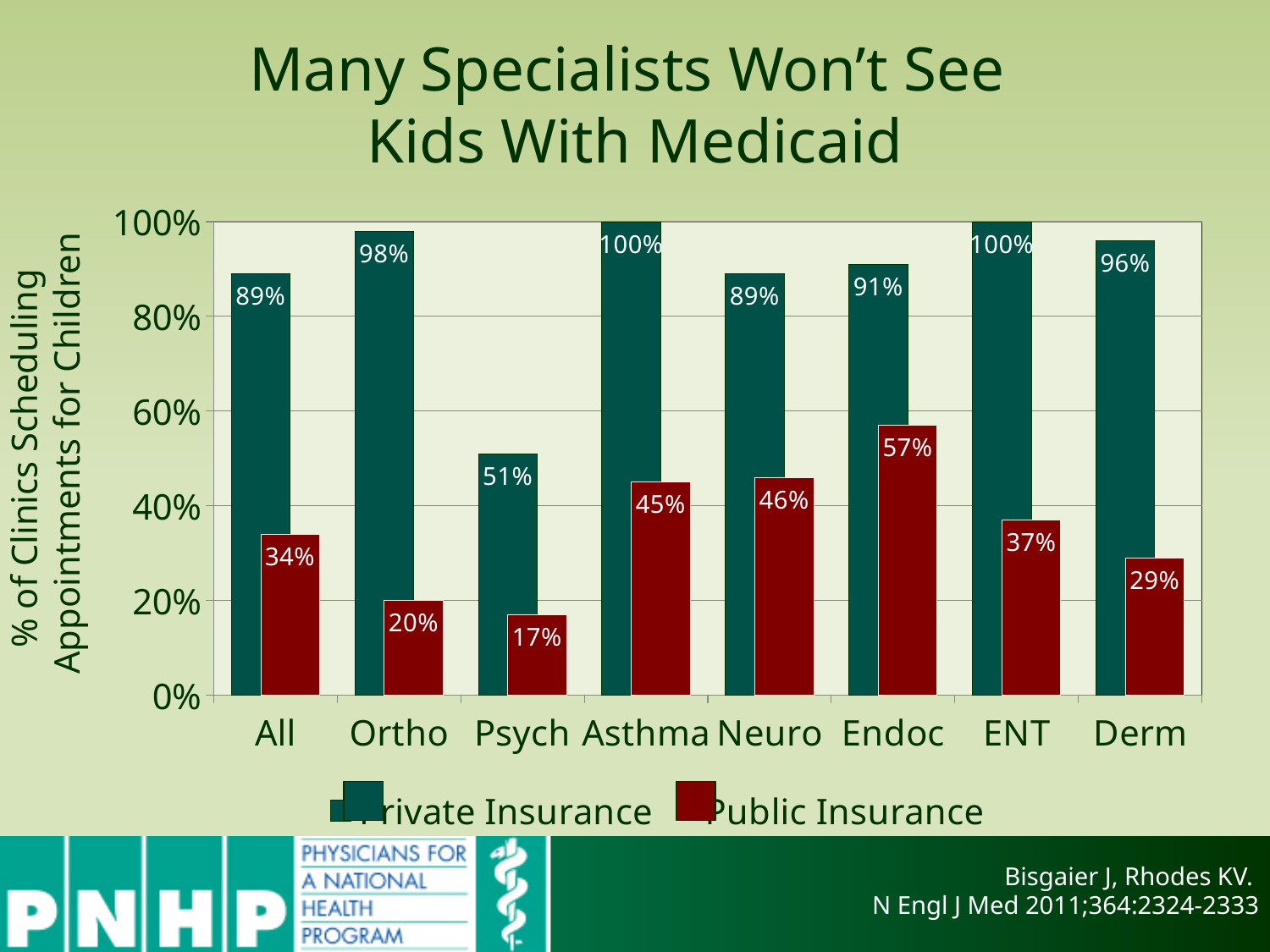
What is the title of the chart on the slide? Many Specialists Won't See Kids With Medicaid What is the Private Insurance value for Ortho? 98% What is the Public Insurance value for Psych? 17% What kind of chart is shown on the slide? Bar chart Which category has the lowest Public Insurance value? Psych What is the Public Insurance value for Endoc? 57% How many series does the legend list? 2 How many categories are shown on the x axis? 8 Which is larger: the Public Insurance value for Neuro or for ENT? Neuro What is the difference between the Private Insurance and Public Insurance values for Ortho? 78% Which category has the lowest Private Insurance value? Psych Which category has the highest Public Insurance value? Endoc